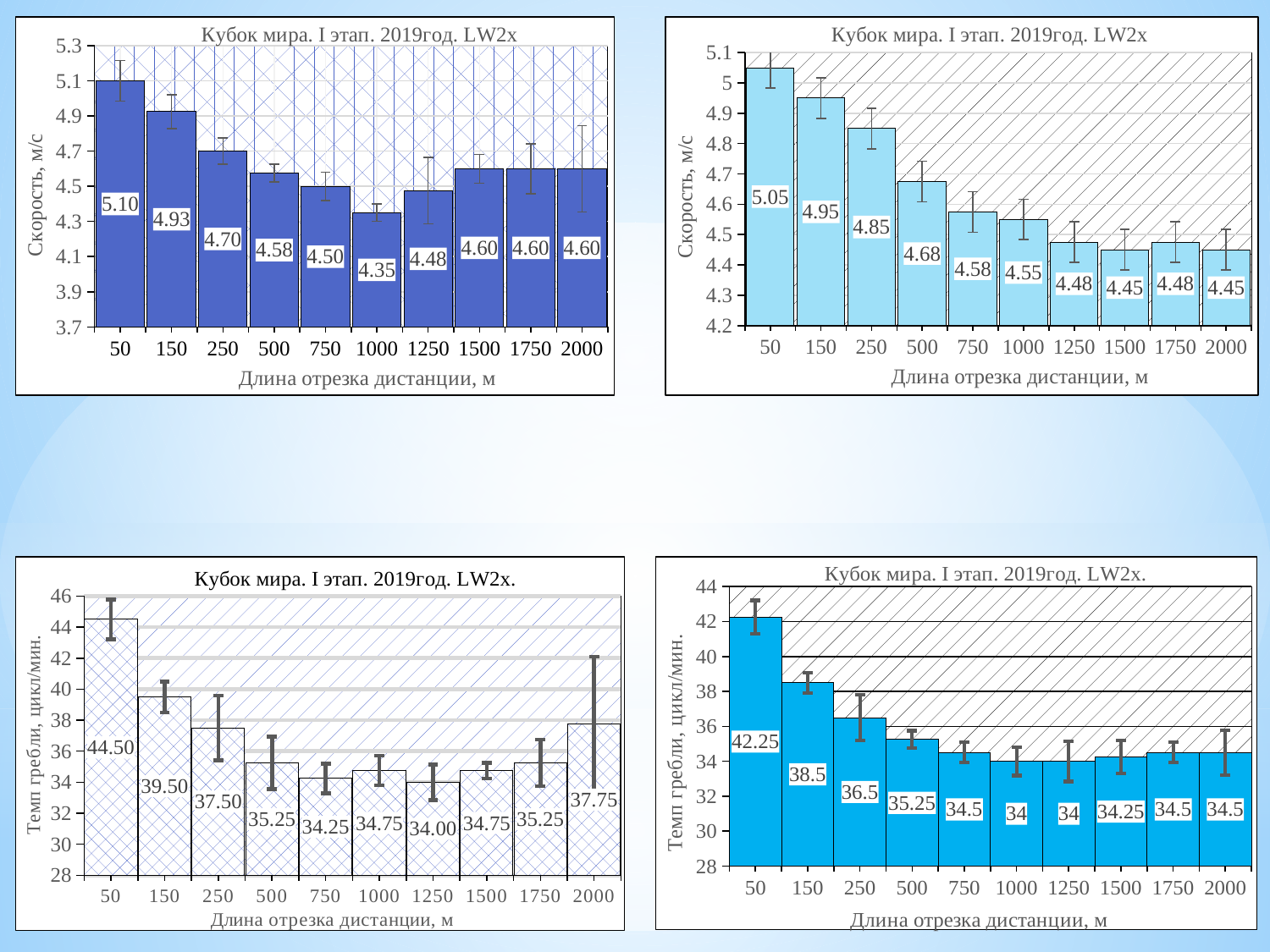
In the top-left chart, which distance segment has the highest speed? 50 In the top-right chart, which is larger: the speed at 750 m or the speed at 1000 m? 750 m In the bottom-left chart, which distance segment has the lowest stroke rate? 1250 In the top-left chart, which distance segment has the lowest speed? 1000 In the bottom-right chart, what is the difference between the stroke rate at 50 m and at 150 m? 3.75 In the top-left chart, what is the speed value for the 1000 m segment? 4.35 In the bottom-left chart, what is the stroke rate value for the 50 m segment? 44.50 In the bottom-right chart, what is the stroke rate value for the 150 m segment? 38.5 How many distance segments are shown on the x axis of the bottom-right chart? 10 In the top-right chart, what is the speed value for the 500 m segment? 4.68 In the top-right chart, what is the difference between the speed at 50 m and the speed at 2000 m? 0.60 What type of chart is the top-left chart? Bar chart